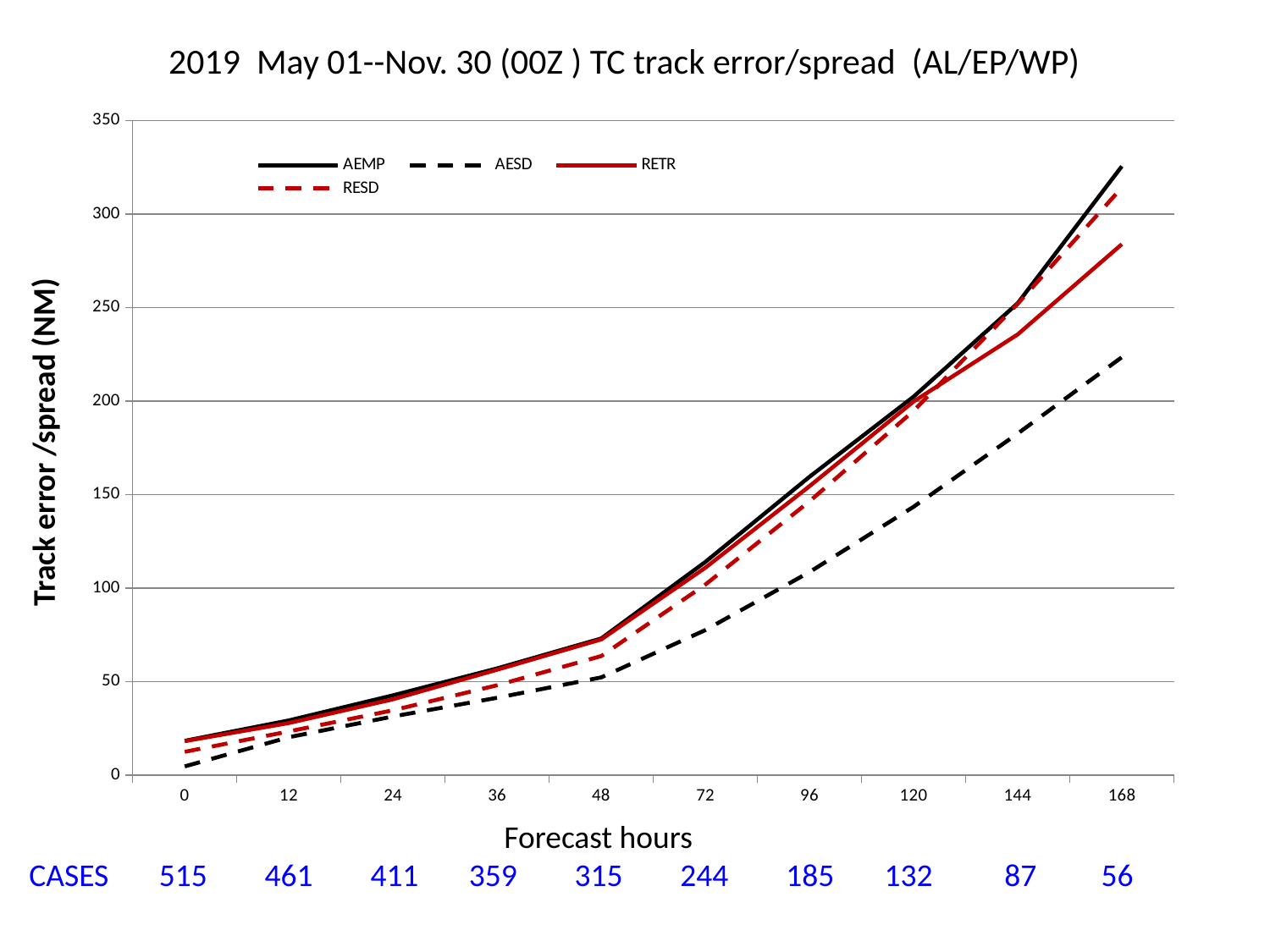
How many series does the legend list? 4 Is the value for AEMP at 96 forecast hours greater or less than 150? greater What kind of chart is shown on the slide? line chart What is the label of the y axis? Track error /spread (NM) Is the value for AESD at 168 forecast hours greater or less than 250? less How many forecast-hour points are shown along the x axis? 10 Is the value for AEMP at 168 forecast hours greater or less than 300? greater Do the values of the AEMP series rise or fall as forecast hours increase? rise At 168 forecast hours, which is larger, RESD or RETR? RESD Which series has the lowest value at 168 forecast hours? AESD Which series has the highest value at 168 forecast hours? AEMP